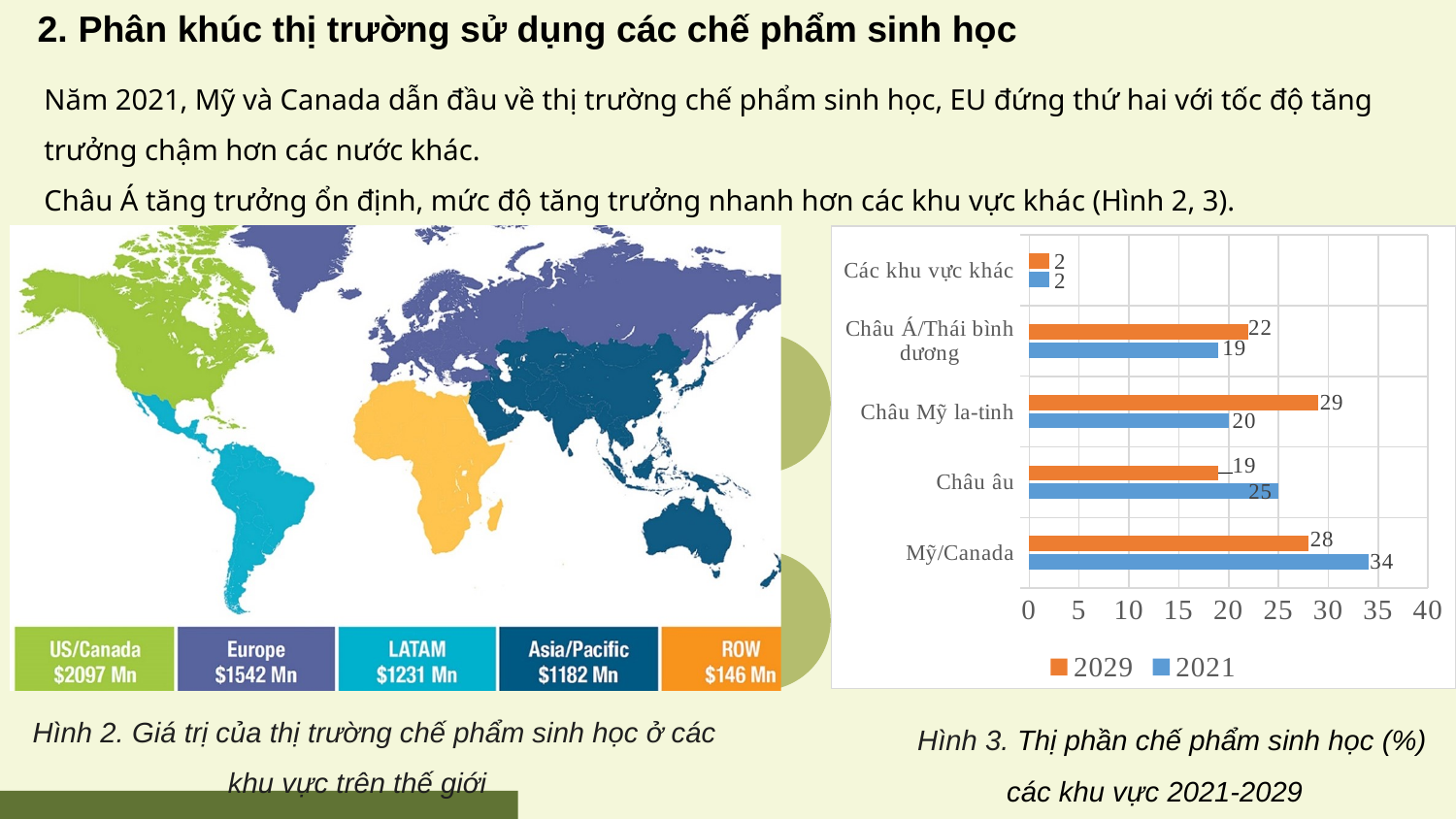
In Hình 3, which region has the lowest value in the 2029 series? Các khu vực khác In Hình 3, what is the value for Châu âu in the 2021 series? 25 In Hình 3, how many series does the legend list? 2 In Hình 3, which region has the highest value in the 2021 series? Mỹ/Canada In Hình 3, what is the value for Châu Mỹ la-tinh in the 2029 series? 29 In Hình 3, what is the value for Châu Á/Thái bình dương in the 2029 series? 22 In Hình 2, what is the market value shown for US/Canada? $2097 Mn In Hình 3, how many regions are shown on the vertical axis? 5 In Hình 3, which series is shown in orange? 2029 What kind of chart is Hình 3? Bar chart In Hình 3, what is the difference between the 2021 and 2029 values for Mỹ/Canada? 6 In Hình 3, for Châu âu, which series has the larger value, 2029 or 2021? 2021